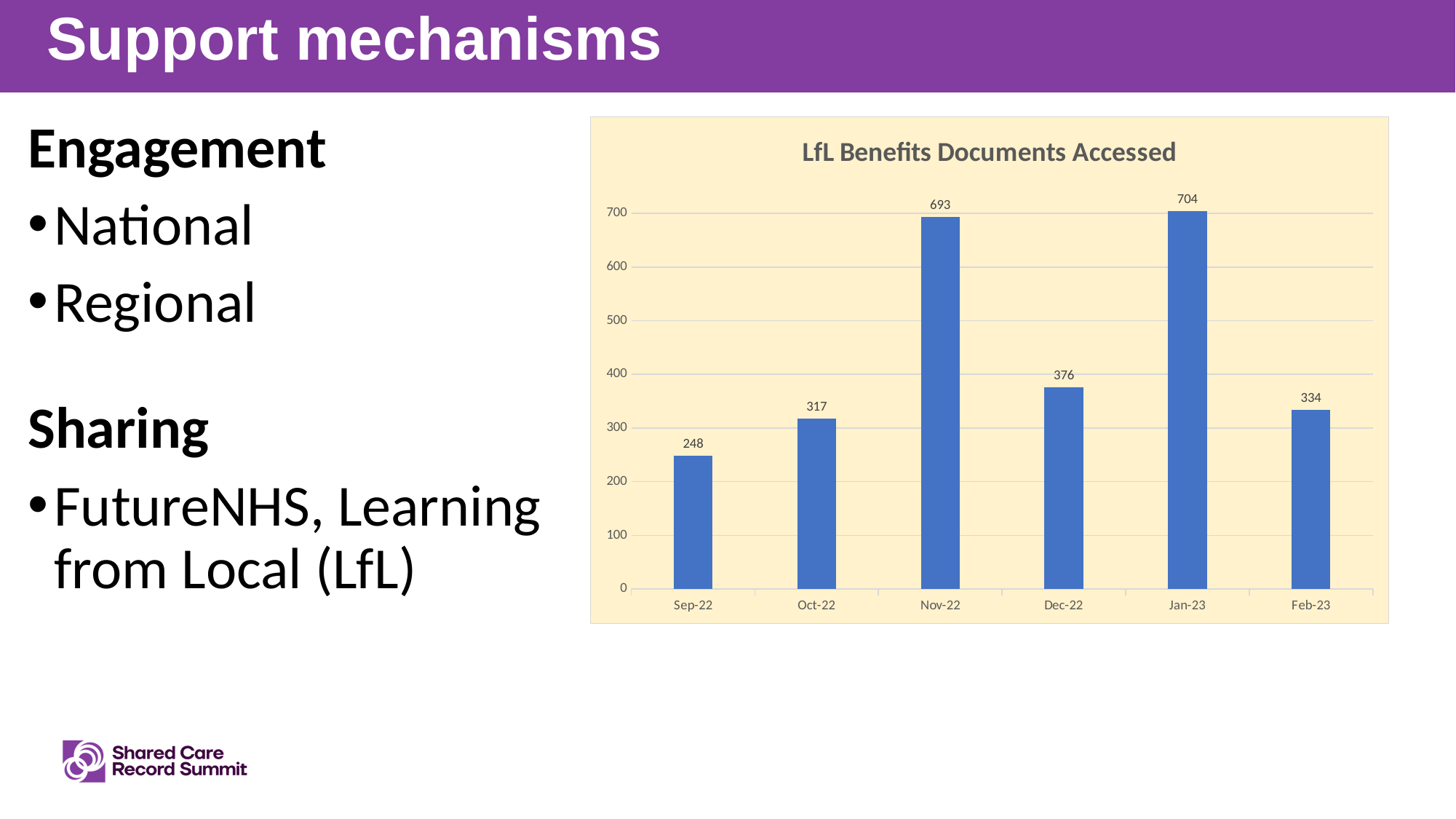
What is the difference between the values for Oct-22 and Sep-22? 69 Which is larger, the value for Dec-22 or the value for Feb-23? Dec-22 Which month has the lowest number of LfL Benefits Documents Accessed? Sep-22 What is the value for Feb-23? 334 Is the value for Nov-22 greater or less than 600? greater What is the value for Sep-22? 248 Which month has the highest number of LfL Benefits Documents Accessed? Jan-23 What is the difference between the values for Jan-23 and Dec-22? 328 How many months are shown on the x axis? 6 What is the value for Nov-22? 693 What is the title of the chart? LfL Benefits Documents Accessed What kind of chart is shown on the slide? Bar chart